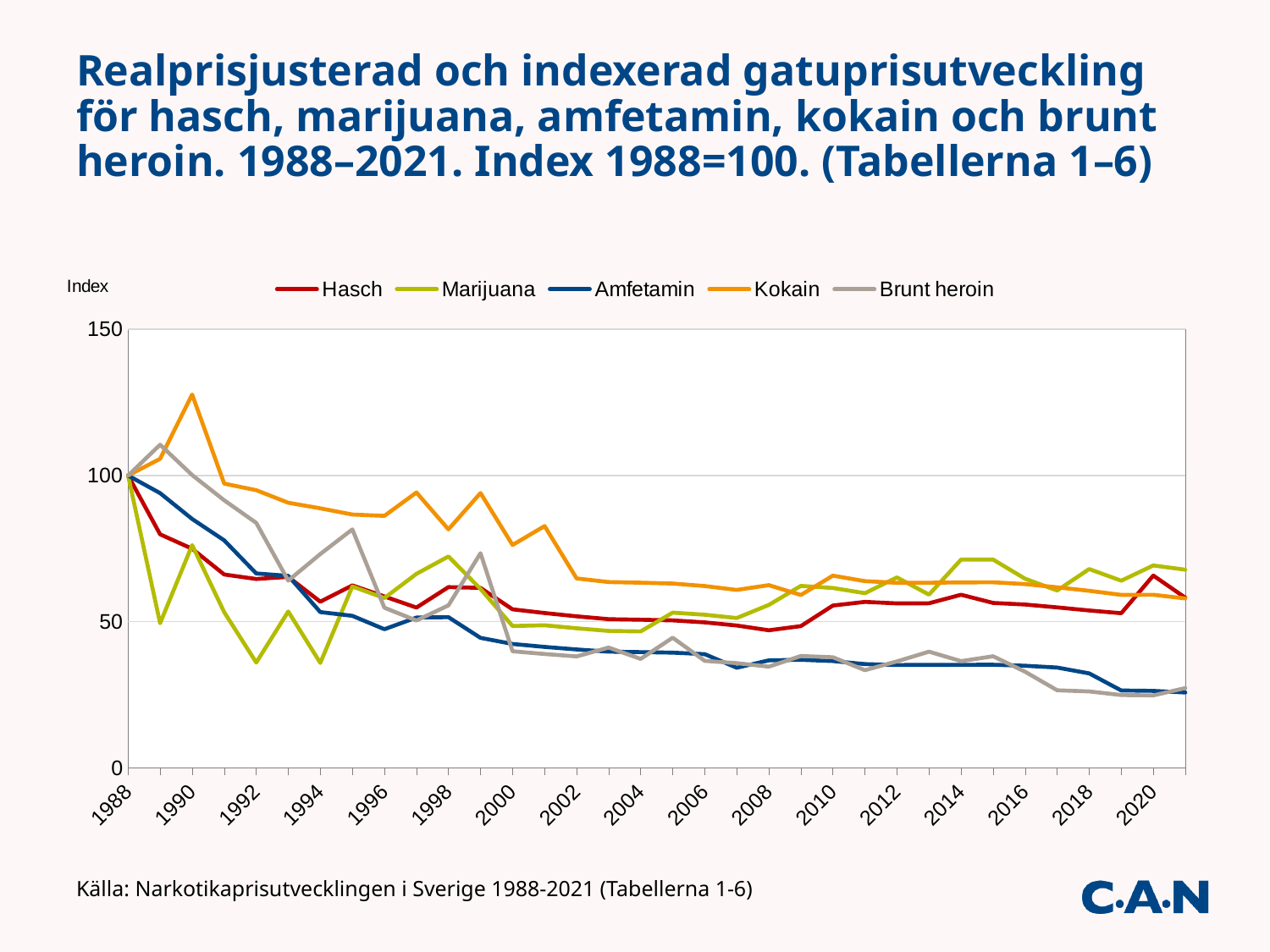
Is the value for Amfetamin in 2020 greater or less than 50? less Which series has the lowest value in 1992? Marijuana In 2000, which is higher, Kokain or Amfetamin? Kokain Is the value for Hasch in 2010 greater or less than 50? greater Is the value for Kokain in 1990 greater or less than 100? greater How many series does the legend list? 5 Which series has the highest value in 1990? Kokain What is the index value for Kokain in 1988? 100 What kind of chart is shown on the slide? line chart Does the Amfetamin line generally rise or fall from 1988 to 2021? fall Which series has the highest value in 2021? Marijuana What is the index value for Hasch in 1988? 100